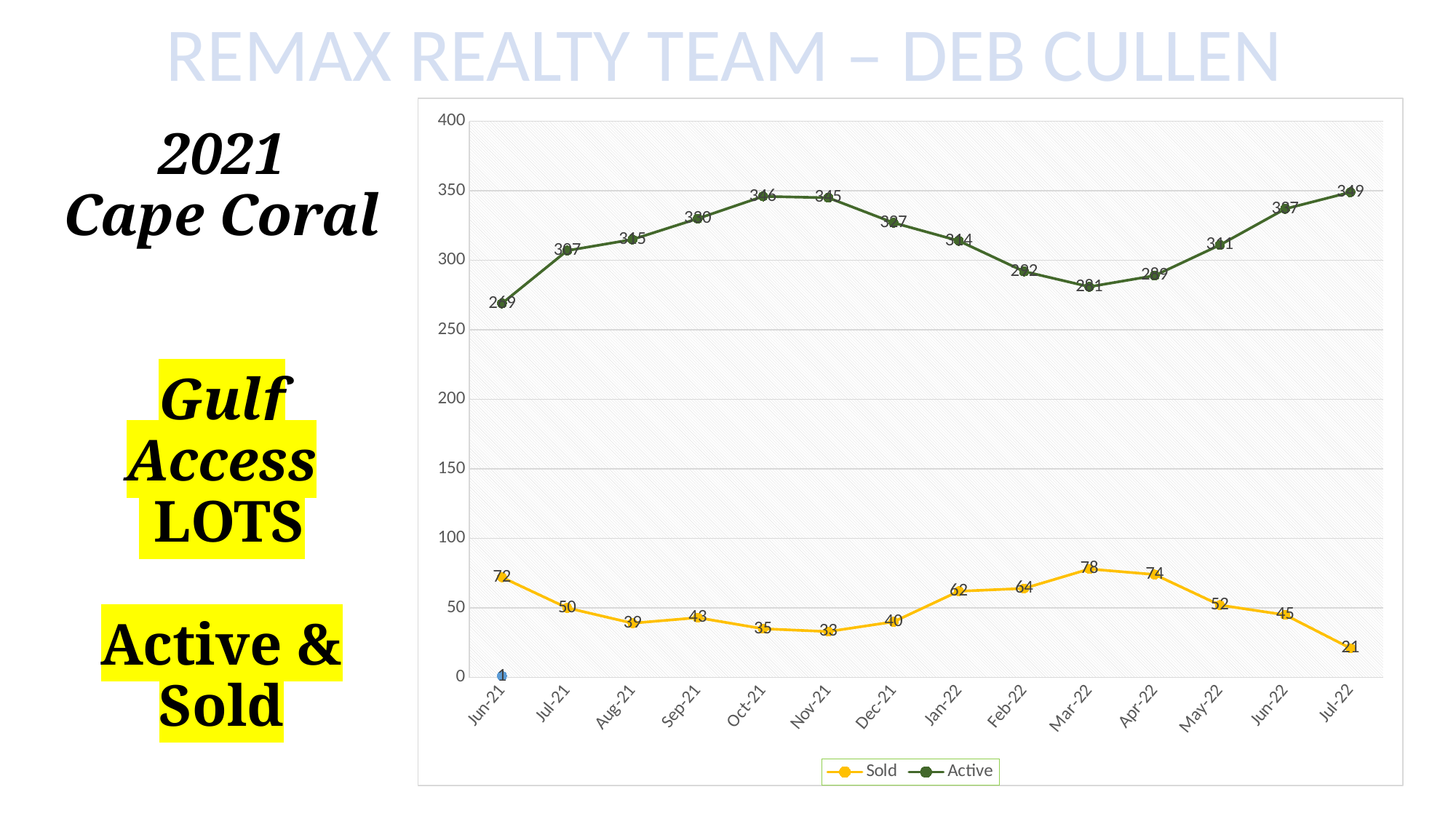
In which month is the Sold value highest? Mar-22 What is the Active value for Jun-21? 269 In which month is the Active value lowest? Jun-21 In which month is the Sold value lowest? Jul-22 What kind of chart is shown on the slide? line chart How many months are shown on the x axis? 14 What is the difference between the Sold values for Jun-21 and Jul-22? 51 What is the Sold value for Jul-22? 21 What is the Sold value for Mar-22? 78 Which is larger, the Active value for Oct-21 or for Dec-21? Oct-21 How many series does the legend list? 2 Is the Active value for Jun-21 greater or less than 300? less